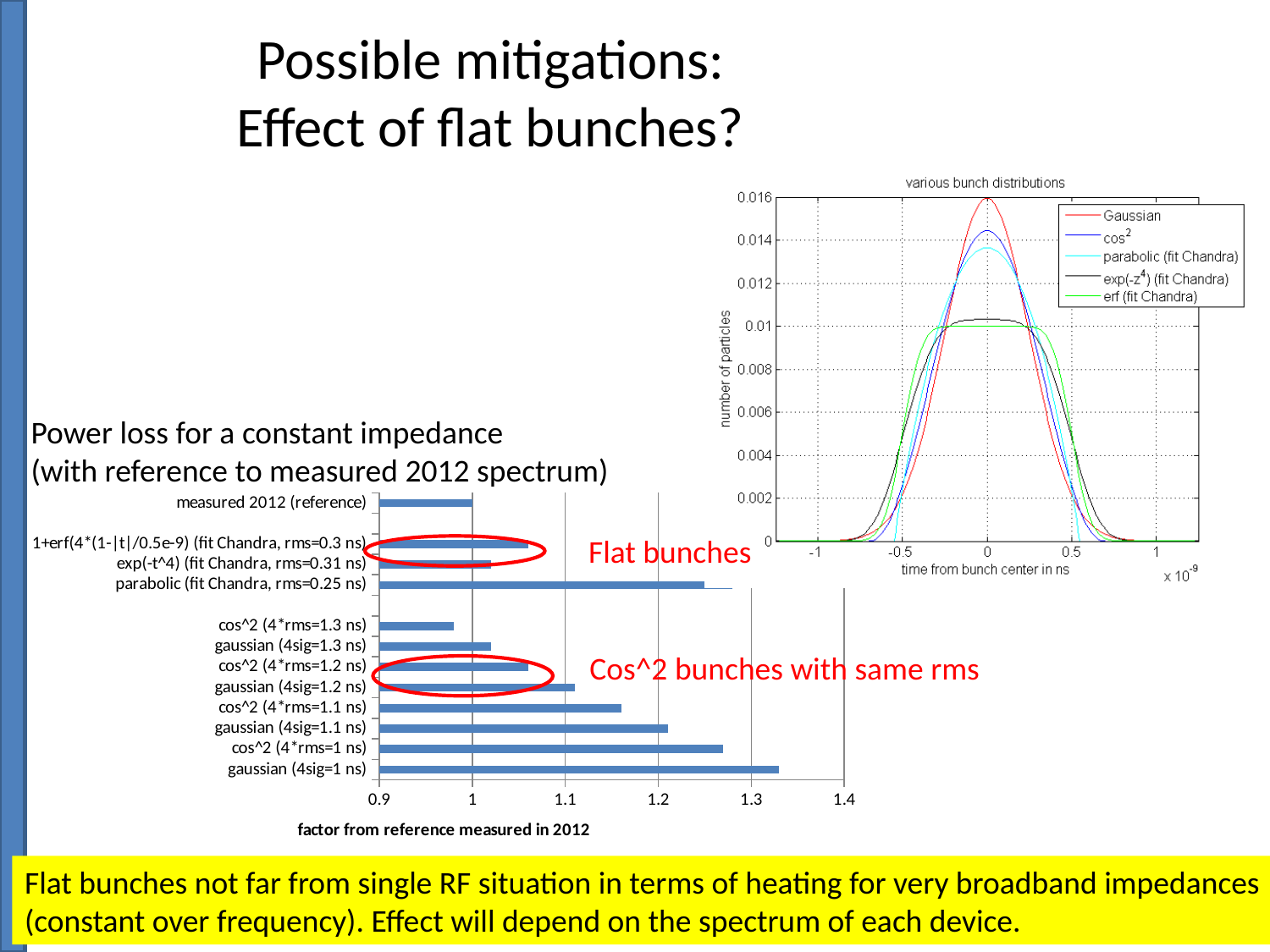
In the bar chart on the left, is the value for 'parabolic (fit Chandra, rms=0.25 ns)' greater or less than 1.2? greater In the 'various bunch distributions' chart on the right, which curve reaches the highest peak? Gaussian In the bar chart on the left, which category has the lowest value? cos^2 (4*rms=1.3 ns) In the bar chart on the left, what is the x-axis title? factor from reference measured in 2012 What kind of chart is the 'Power loss for a constant impedance' chart on the left? bar chart In the 'various bunch distributions' chart on the right, how many series does the legend list? 5 In the bar chart on the left, what is the value for 'measured 2012 (reference)'? 1 In the bar chart on the left, which is larger: 'gaussian (4sig=1.2 ns)' or 'cos^2 (4*rms=1.2 ns)'? gaussian (4sig=1.2 ns) In the bar chart on the left, which category has the highest value? gaussian (4sig=1 ns) In the bar chart on the left, is the value for 'cos^2 (4*rms=1.3 ns)' greater or less than 1? less In the bar chart on the left, how many categories are plotted? 12 In the 'various bunch distributions' chart on the right, what is the y-axis label? number of particles